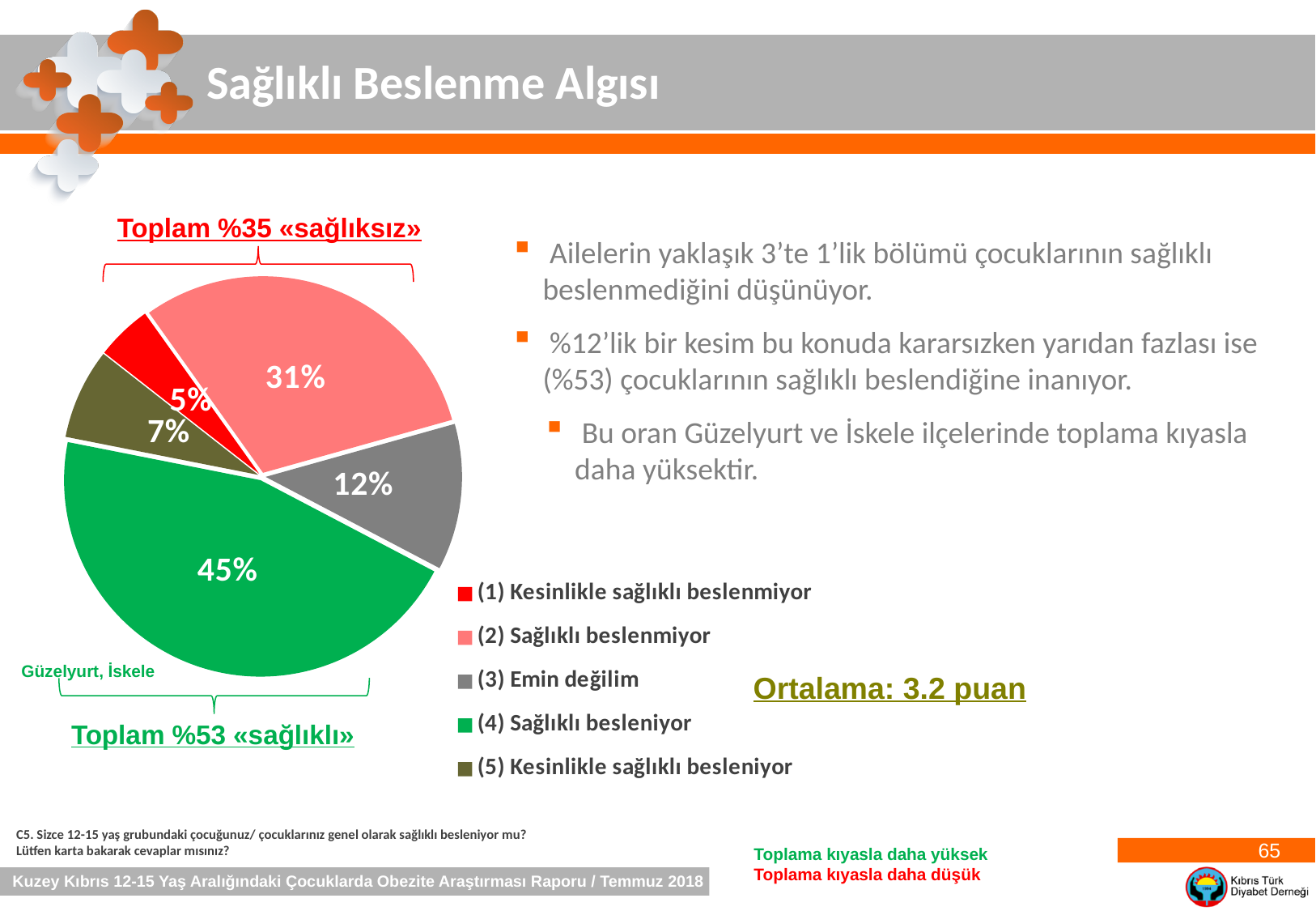
What percentage of the pie is labelled for "(5) Kesinlikle sağlıklı besleniyor"? 7% Which is larger: the slice for "(3) Emin değilim" or the slice for "(5) Kesinlikle sağlıklı besleniyor"? (3) Emin değilim What percentage of the pie is labelled for "(3) Emin değilim"? 12% Which category has the smallest slice of the pie? (1) Kesinlikle sağlıklı beslenmiyor How many categories does the legend of the pie chart list? 5 What percentage of the pie is labelled for "(2) Sağlıklı beslenmiyor"? 31% What is the difference in percentage points between "(4) Sağlıklı besleniyor" and "(2) Sağlıklı beslenmiyor"? 14 What colour is the slice for "(3) Emin değilim"? Gray What percentage of the pie is labelled for "(4) Sağlıklı besleniyor"? 45% What percentage of the pie is labelled for "(1) Kesinlikle sağlıklı beslenmiyor"? 5% What kind of chart is shown on the slide? Pie chart Which category has the largest slice of the pie? (4) Sağlıklı besleniyor